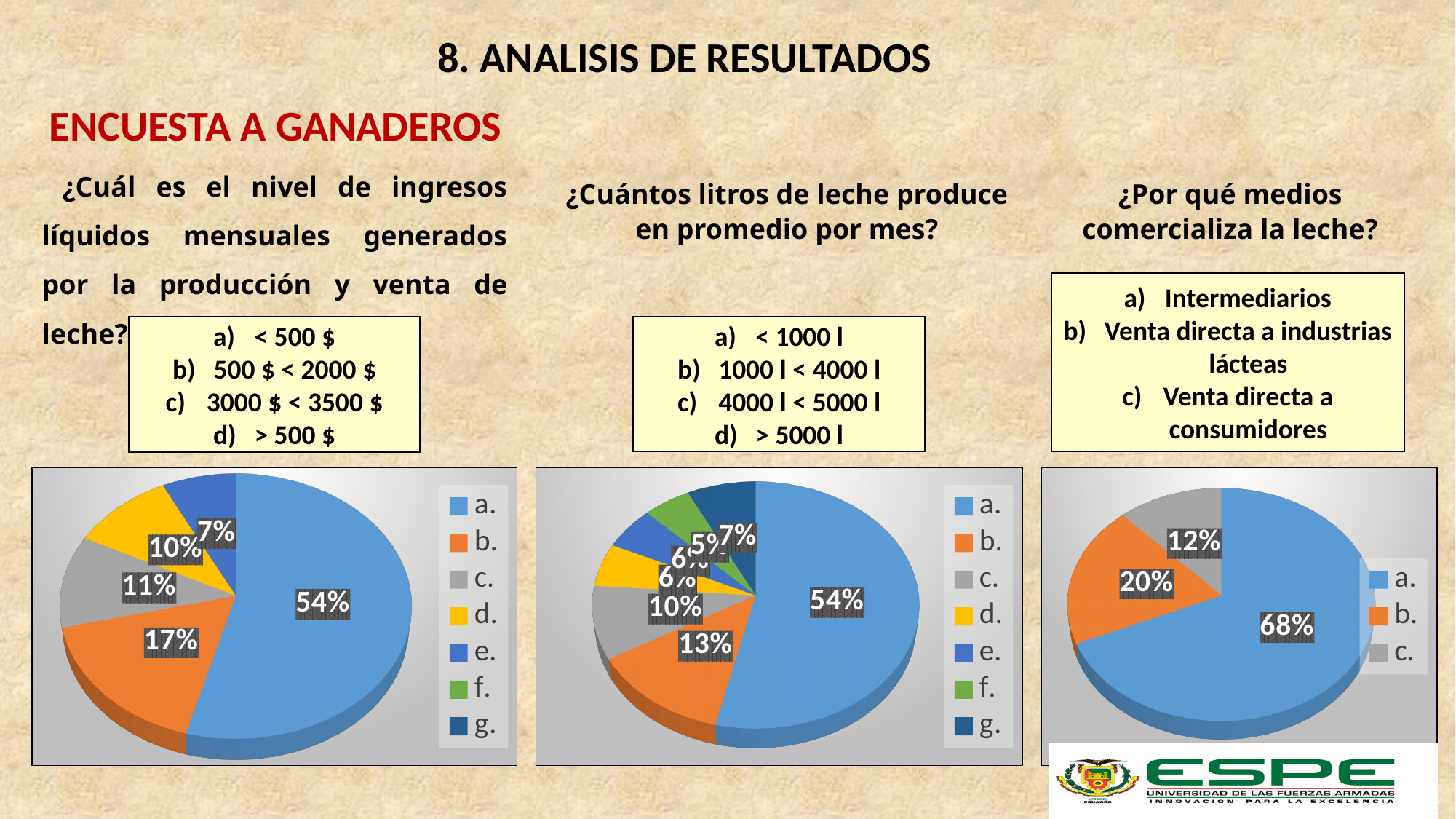
In the right pie chart (means of commercialising milk), which option has the smallest share? c. In the left pie chart (monthly income), what is the difference in percentage points between option a. and option b.? 37 percentage points What type of chart is used on the right of the slide for the question about means of commercialising milk? Pie chart In the middle pie chart (litres of milk per month), which is larger, option b. or option c.? b. In the right pie chart (means of commercialising milk), what share does option a. have? 68% In the right pie chart (means of commercialising milk), how many slices are there? 3 In the left pie chart (monthly income), what share does option b. have? 17% In the middle pie chart (litres of milk per month), what share does option a. have? 54% In the middle pie chart (litres of milk per month), what share does option b. have? 13% In the left pie chart (monthly income), what share does option a. have? 54% In the left pie chart (monthly income), how many entries does the legend list? 7 In the left pie chart (monthly income), which option has the largest share? a.